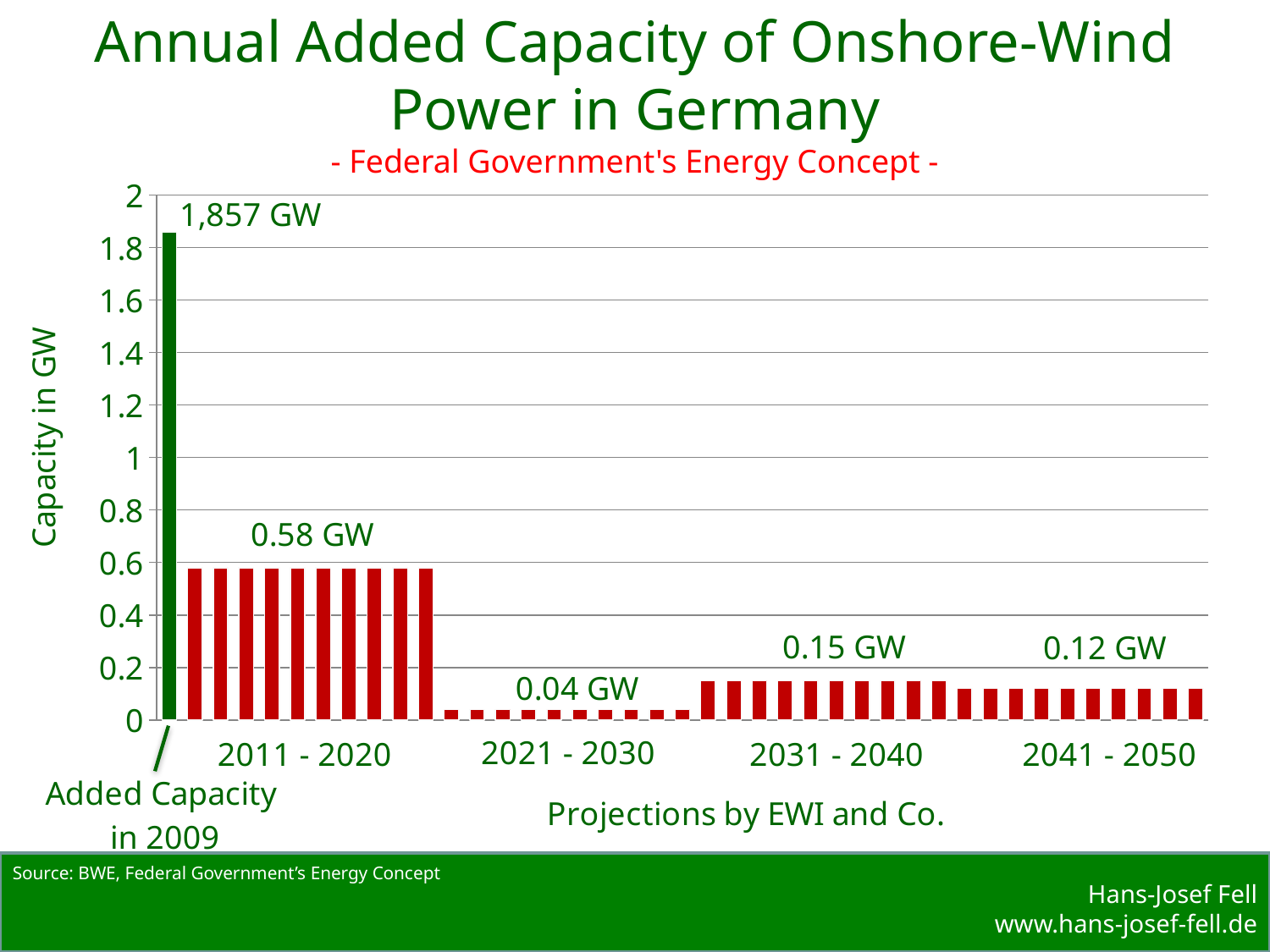
What annual added capacity is projected for the period 2021 - 2030? 0.04 GW What is the annual added capacity shown for 2009? 1,857 GW What is the label of the y axis? Capacity in GW Which period has the lowest projected annual added capacity? 2021 - 2030 What annual added capacity is projected for the period 2031 - 2040? 0.15 GW Are the bars for 2011 - 2020 greater or less than 0.4 GW? greater Which bar shows the highest annual added capacity? Added Capacity in 2009 What annual added capacity is projected for the period 2011 - 2020? 0.58 GW What is the difference between the annual added capacity for 2011 - 2020 and for 2021 - 2030? 0.54 GW Which period has a larger projected annual added capacity, 2031 - 2040 or 2041 - 2050? 2031 - 2040 What annual added capacity is projected for the period 2041 - 2050? 0.12 GW What type of chart is shown on the slide? bar chart